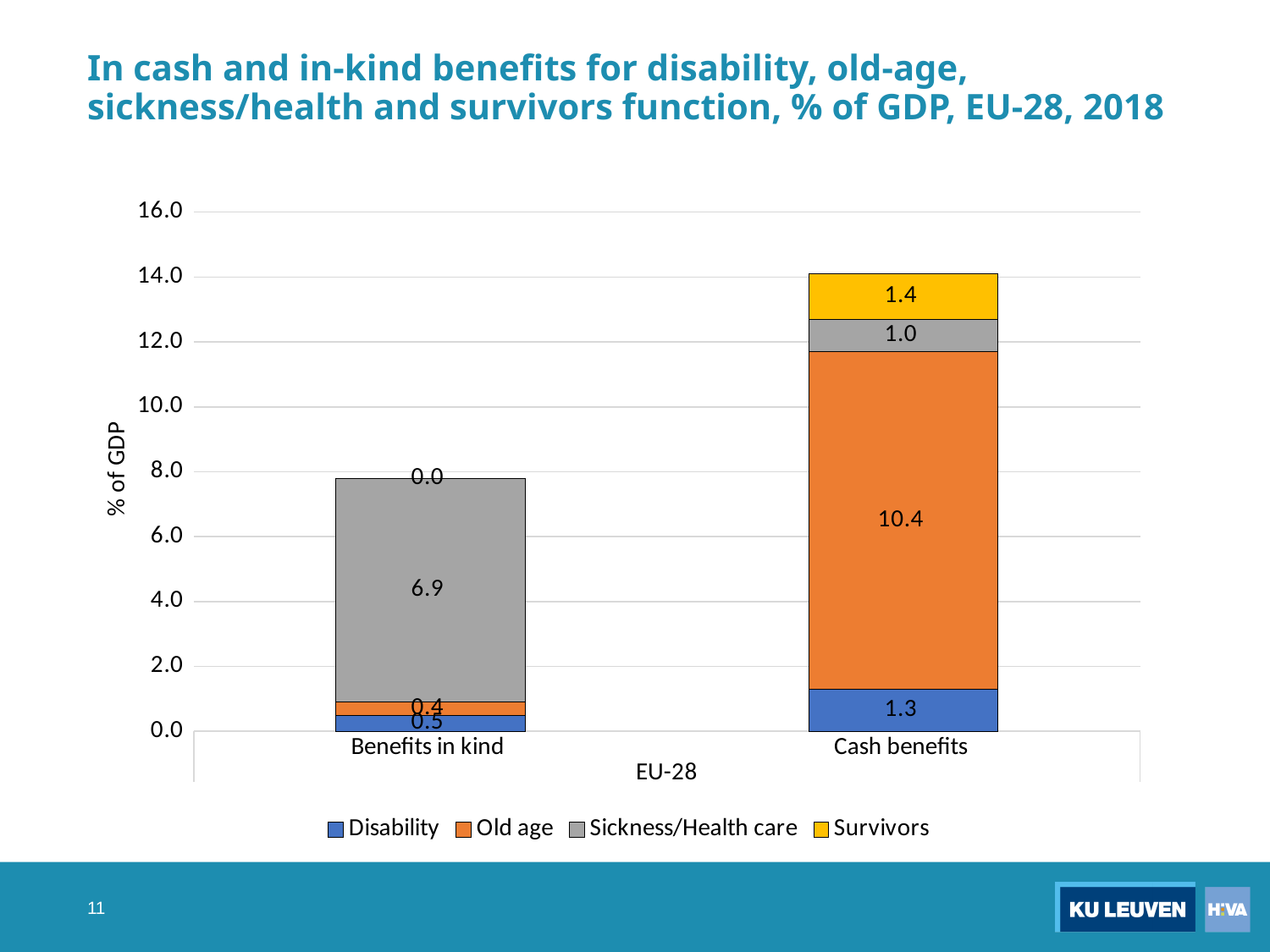
What is the value for Sickness/Health care in the Benefits in kind bar? 6.9 What is the total of the Cash benefits stacked bar? 14.1 What kind of chart is shown on the slide? Stacked bar chart Which is larger: the Disability value for Cash benefits or the Disability value for Benefits in kind? Cash benefits What is the value for Survivors in the Cash benefits bar? 1.4 What is the value for Survivors in the Benefits in kind bar? 0.0 What is the difference between the Old age value for Cash benefits and the Old age value for Benefits in kind? 10.0 How many series does the legend list? 4 Which series has the largest value in the Cash benefits bar? Old age What is the value for Disability in the Benefits in kind bar? 0.5 Which series has the smallest value in the Benefits in kind bar? Survivors What is the value for Old age in the Cash benefits bar? 10.4